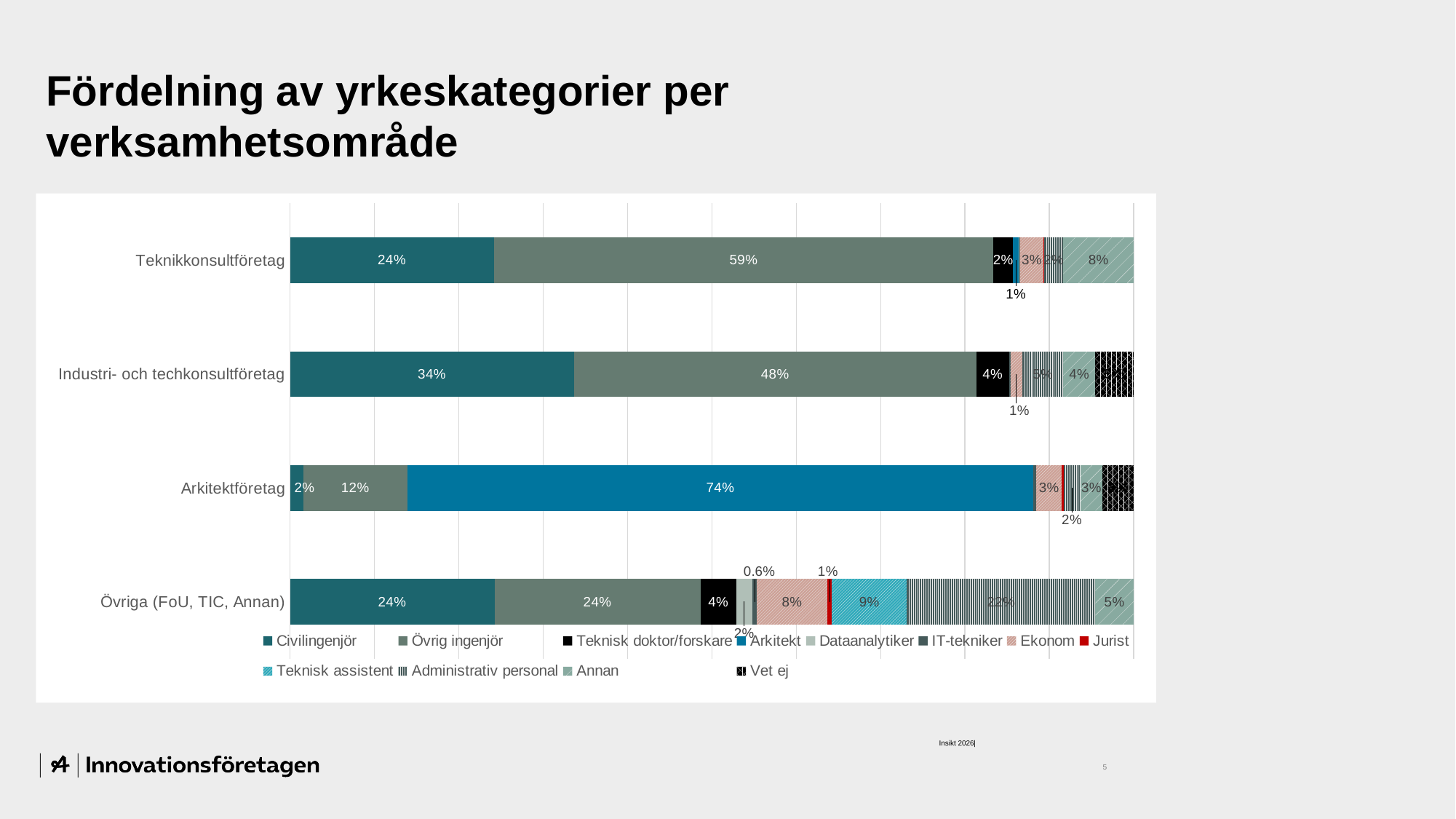
Which has a larger share of Övrig ingenjör, Teknikkonsultföretag or Industri- och techkonsultföretag? Teknikkonsultföretag What is the difference in the Civilingenjör share between Industri- och techkonsultföretag and Teknikkonsultföretag? 10 percentage points What is the share of Teknisk assistent for Övriga (FoU, TIC, Annan)? 9% What is the share of Övrig ingenjör for Teknikkonsultföretag? 59% What is the share of Civilingenjör for Industri- och techkonsultföretag? 34% Which category has the highest share of Civilingenjör? Industri- och techkonsultföretag How many verksamhetsområde categories are plotted on the chart? 4 What is the share of Administrativ personal for Övriga (FoU, TIC, Annan)? 22% How many series does the legend list? 12 What kind of chart is shown on the slide? Stacked bar chart Which category has the lowest share of Civilingenjör? Arkitektföretag What is the share of Arkitekt for Arkitektföretag? 74%